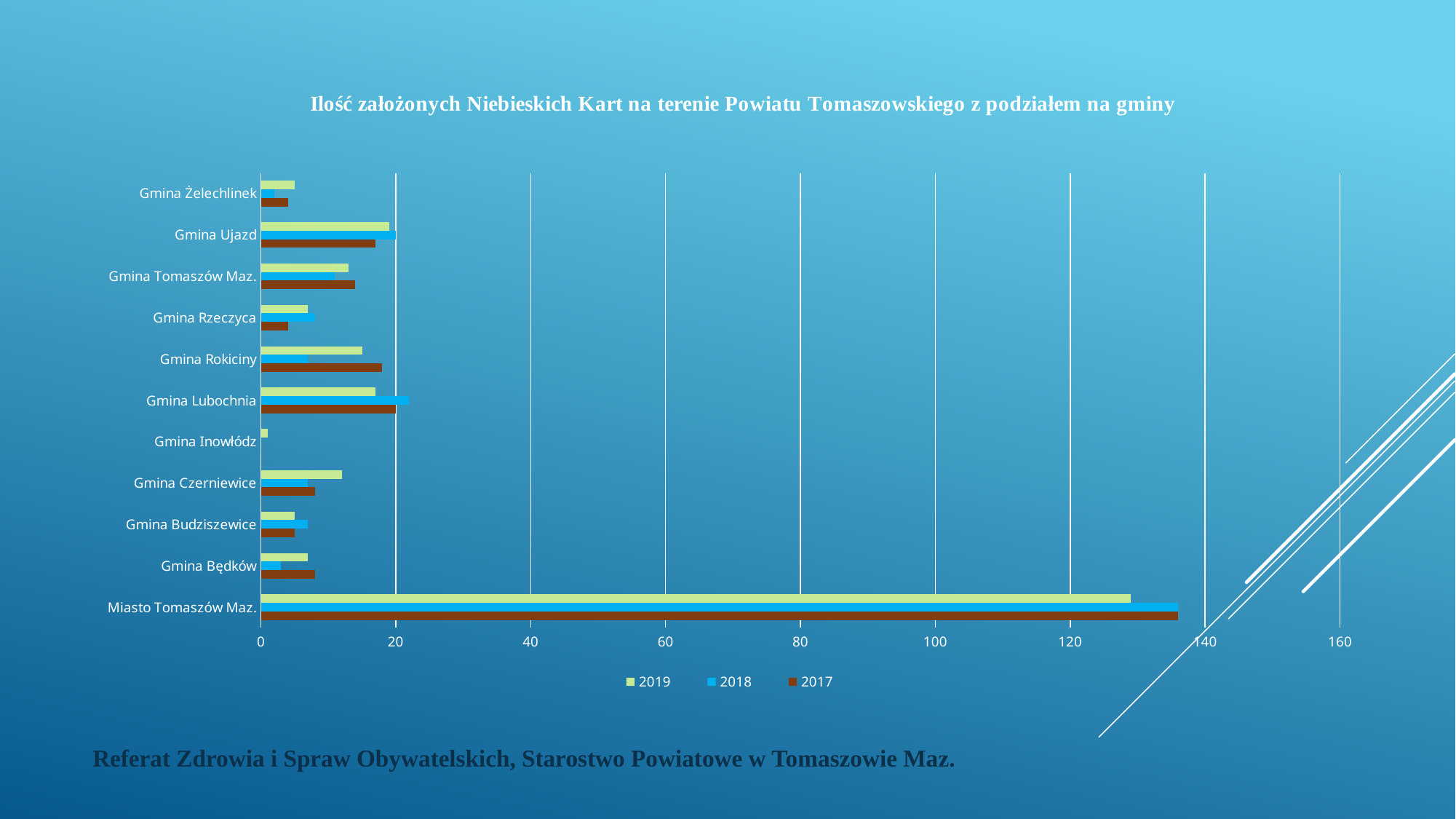
Which years are listed in the chart legend? 2019, 2018, 2017 Which is larger for Gmina Rokiciny: the 2017 value or the 2018 value? 2017 Is the 2018 value for Miasto Tomaszów Maz. greater or less than 140? less Which category has the lowest value for 2019? Gmina Inowłódz Is the 2018 value for Gmina Lubochnia greater or less than 20? greater Which category has the highest value for 2018? Miasto Tomaszów Maz. Is the 2019 value for Gmina Inowłódz greater or less than 20? less Which has the larger 2019 value: Gmina Ujazd or Gmina Żelechlinek? Gmina Ujazd What kind of chart is shown on the slide? bar chart How many series does the legend list? 3 How many gminas (categories) are listed on the chart? 11